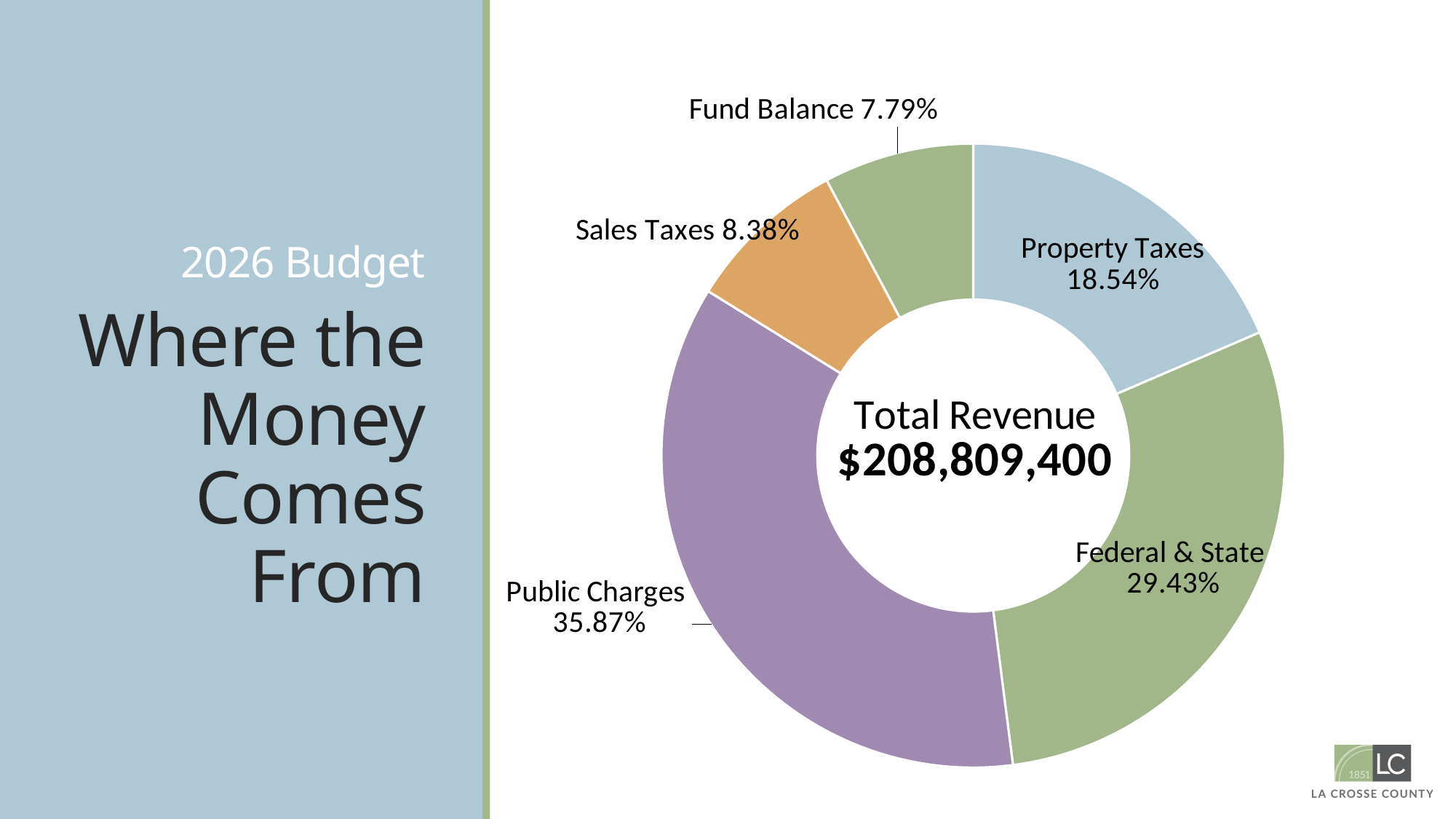
What share of total revenue comes from Federal & State? 29.43% How many revenue categories are shown in the chart? 5 What total revenue figure is shown in the centre of the chart? $208,809,400 What share of total revenue comes from Fund Balance? 7.79% What share of total revenue comes from Property Taxes? 18.54% What share of total revenue comes from Public Charges? 35.87% What share of total revenue comes from Sales Taxes? 8.38% Which revenue source has the largest share? Public Charges Which revenue source has the smallest share? Fund Balance What kind of chart is shown on the slide? Pie chart (donut) What is the difference in percentage points between Public Charges and Federal & State? 6.44 Which is larger, the share for Property Taxes or the share for Sales Taxes? Property Taxes